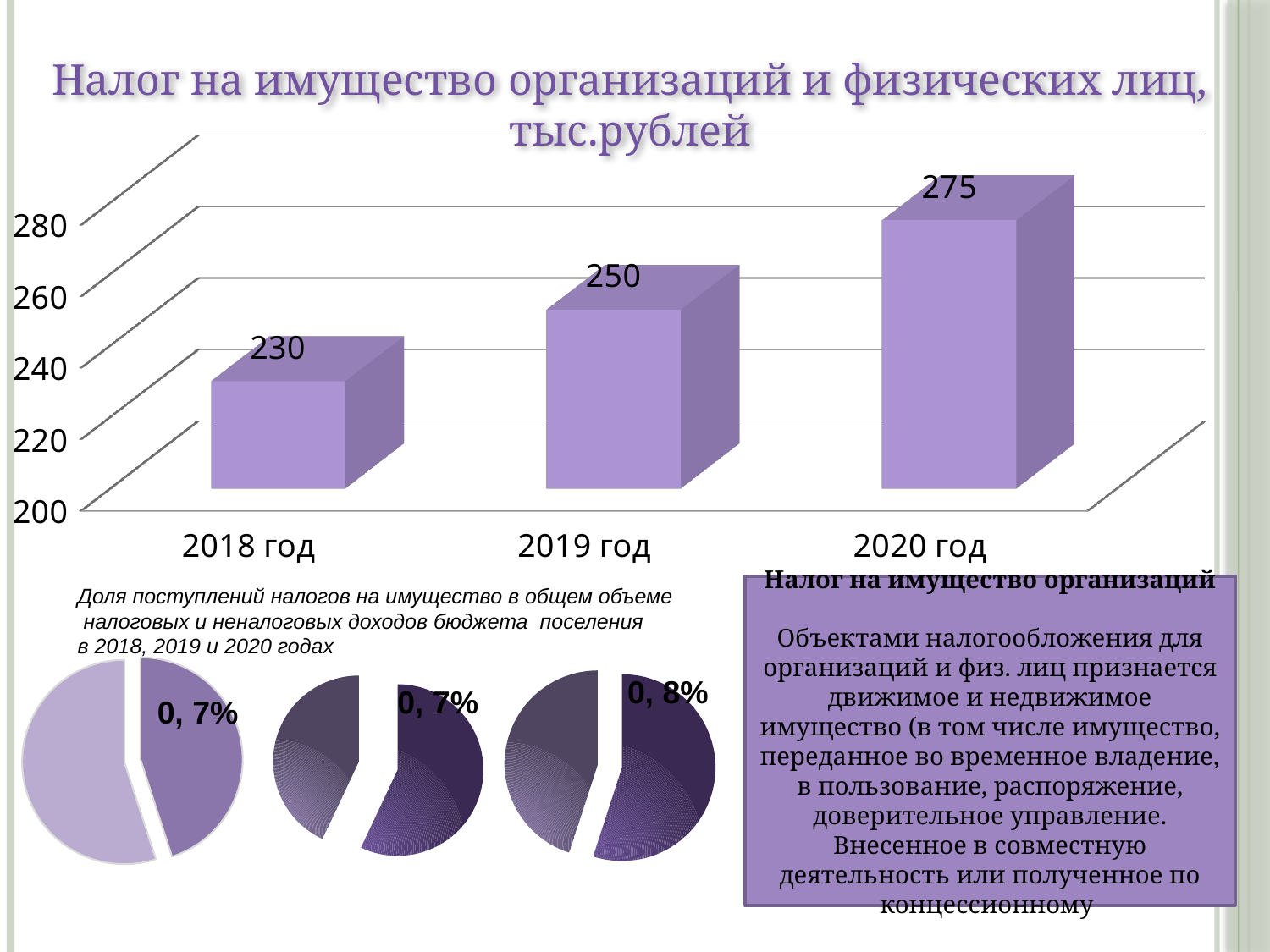
In the bar chart, which is larger: the value for 2019 год or 2020 год? 2020 год In the bar chart, do the values rise or fall from 2018 год to 2020 год? rise In the bar chart, which year has the highest value? 2020 год What type of chart is the chart at the top of the slide? bar chart In the bar chart, what is the value for 2018 год? 230 What is the title of the bar chart at the top of the slide? Налог на имущество организаций и физических лиц, тыс.рублей In the bar chart, what is the value for 2019 год? 250 In the bar chart, what is the value for 2020 год? 275 In the bar chart, what is the difference between the values for 2019 год and 2018 год? 20 How many bars are shown in the bar chart? 3 In the bar chart, which year has the lowest value? 2018 год In the bar chart, what is the difference between the values for 2020 год and 2018 год? 45